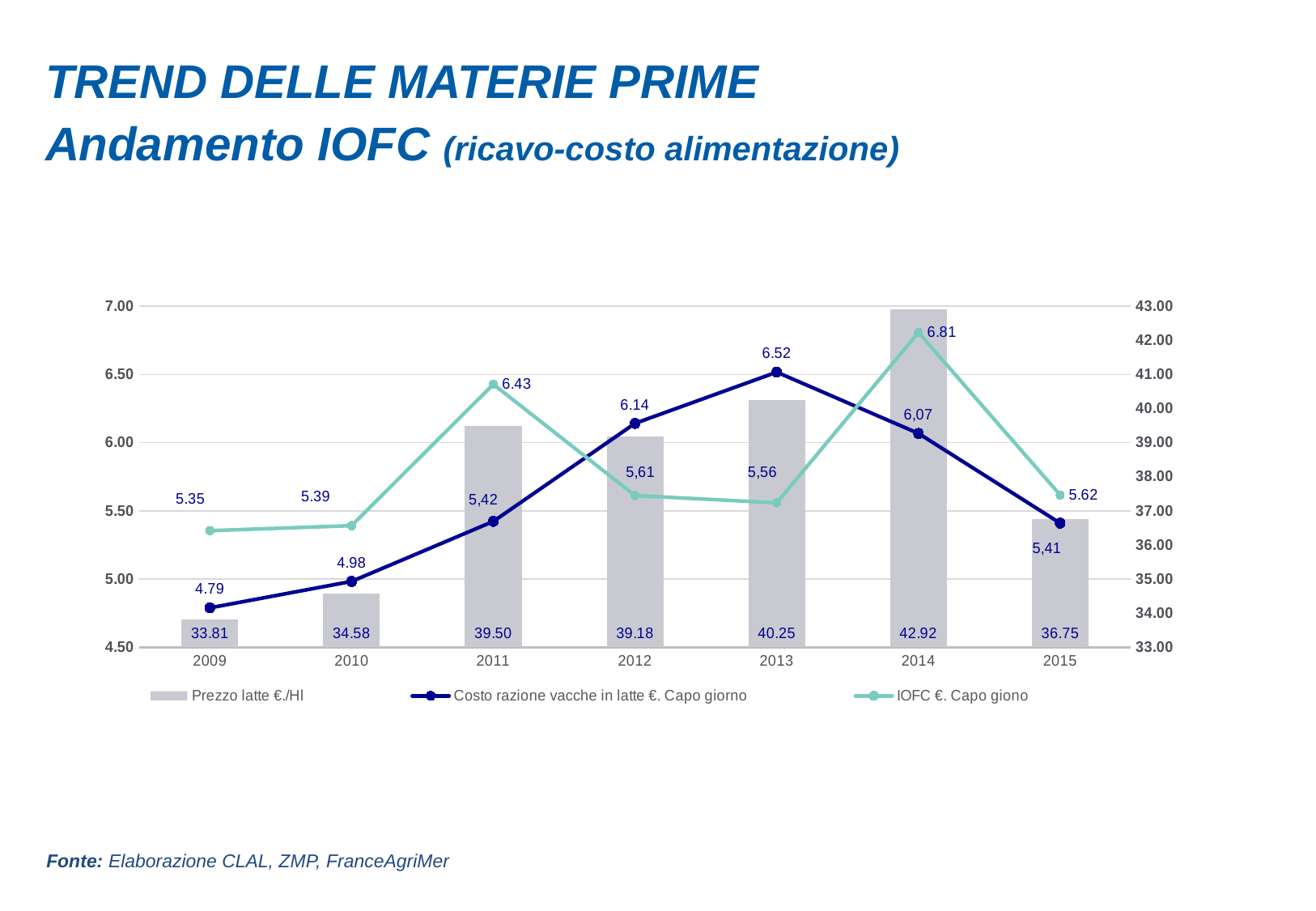
What kind of chart is shown on the slide? Combined bar and line chart In which year does IOFC €. Capo giono reach its highest value? 2014 How many series does the legend list? 3 What is the IOFC €. Capo giono value in 2011? 6.43 How many years are shown on the x axis? 7 What is the value of Prezzo latte €./Hl in 2014? 42.92 What is the difference between Prezzo latte €./Hl in 2014 and in 2015? 6.17 Does Costo razione vacche in latte rise or fall from 2009 to 2013? Rise In which year is Costo razione vacche in latte lowest? 2009 In which year is Prezzo latte €./Hl highest? 2014 What is the Costo razione vacche in latte value in 2013? 6.52 In 2012, which is larger: Costo razione vacche in latte or IOFC €. Capo giono? Costo razione vacche in latte